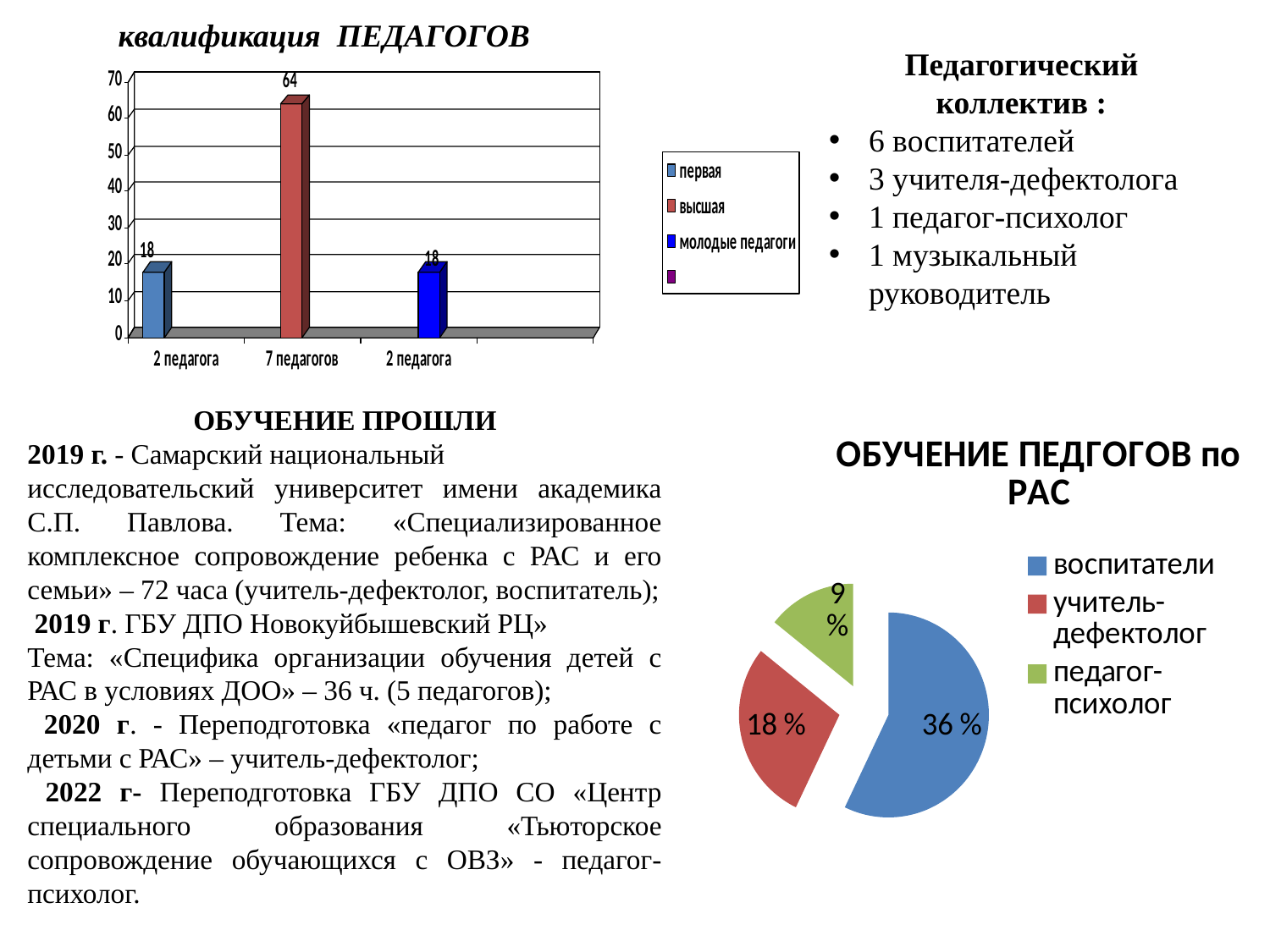
What kind of chart is the chart titled «квалификация ПЕДАГОГОВ»? bar chart In the chart titled «ОБУЧЕНИЕ ПЕДГОГОВ по РАС», what percentage is shown for «воспитатели»? 36 % In the chart titled «квалификация ПЕДАГОГОВ», what value is shown for the «первая» bar? 18 In the chart titled «квалификация ПЕДАГОГОВ», how many bars are plotted? 3 In the chart titled «ОБУЧЕНИЕ ПЕДГОГОВ по РАС», which category has the smallest slice? педагог-психолог What kind of chart is the chart titled «ОБУЧЕНИЕ ПЕДГОГОВ по РАС»? pie chart In the chart titled «ОБУЧЕНИЕ ПЕДГОГОВ по РАС», what percentage is shown for «педагог-психолог»? 9 % In the chart titled «ОБУЧЕНИЕ ПЕДГОГОВ по РАС», what is the difference between the «воспитатели» slice and the «учитель-дефектолог» slice? 18 % In the chart titled «квалификация ПЕДАГОГОВ», is the value of the «высшая» bar greater or less than 60? greater In the chart titled «квалификация ПЕДАГОГОВ», what value is shown for the «высшая» bar? 64 In the chart titled «квалификация ПЕДАГОГОВ», which legend category has the highest bar? высшая In the chart titled «квалификация ПЕДАГОГОВ», what is the difference between the «высшая» bar and the «молодые педагоги» bar? 46